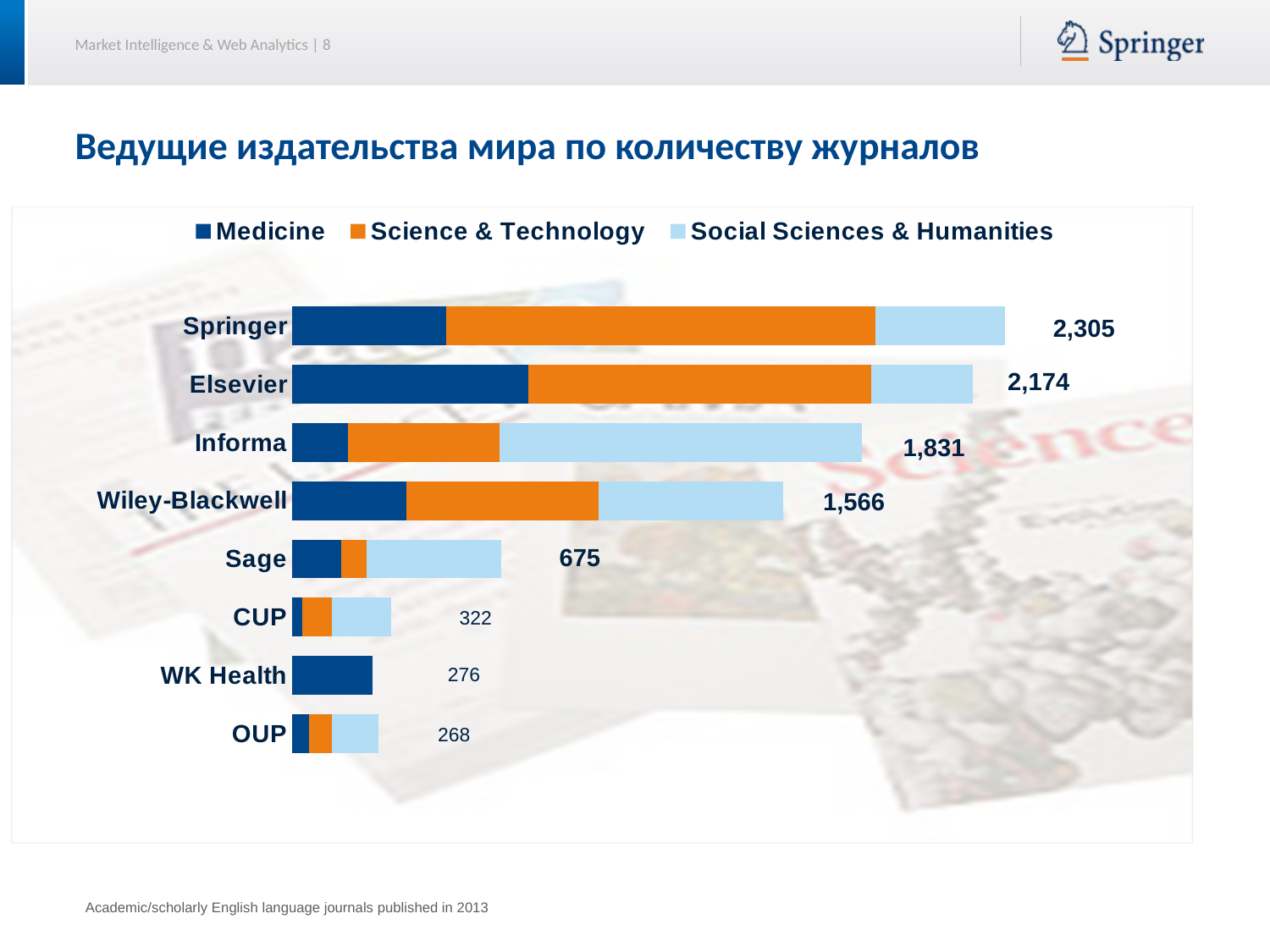
Which publisher has the highest total number of journals? Springer How many publishers are shown in the chart? 8 What kind of chart is shown on the slide? Stacked bar chart What is the total number of journals shown for Springer? 2,305 Which series in the legend is shown in orange? Science & Technology Which has a larger total, Informa or Wiley-Blackwell? Informa What is the difference between the totals for Sage and CUP? 353 What is the total number of journals shown for Informa? 1,831 What is the total number of journals shown for OUP? 268 Which publisher has the lowest total number of journals? OUP What is the difference between the totals for Springer and Elsevier? 131 How many series does the legend list? 3